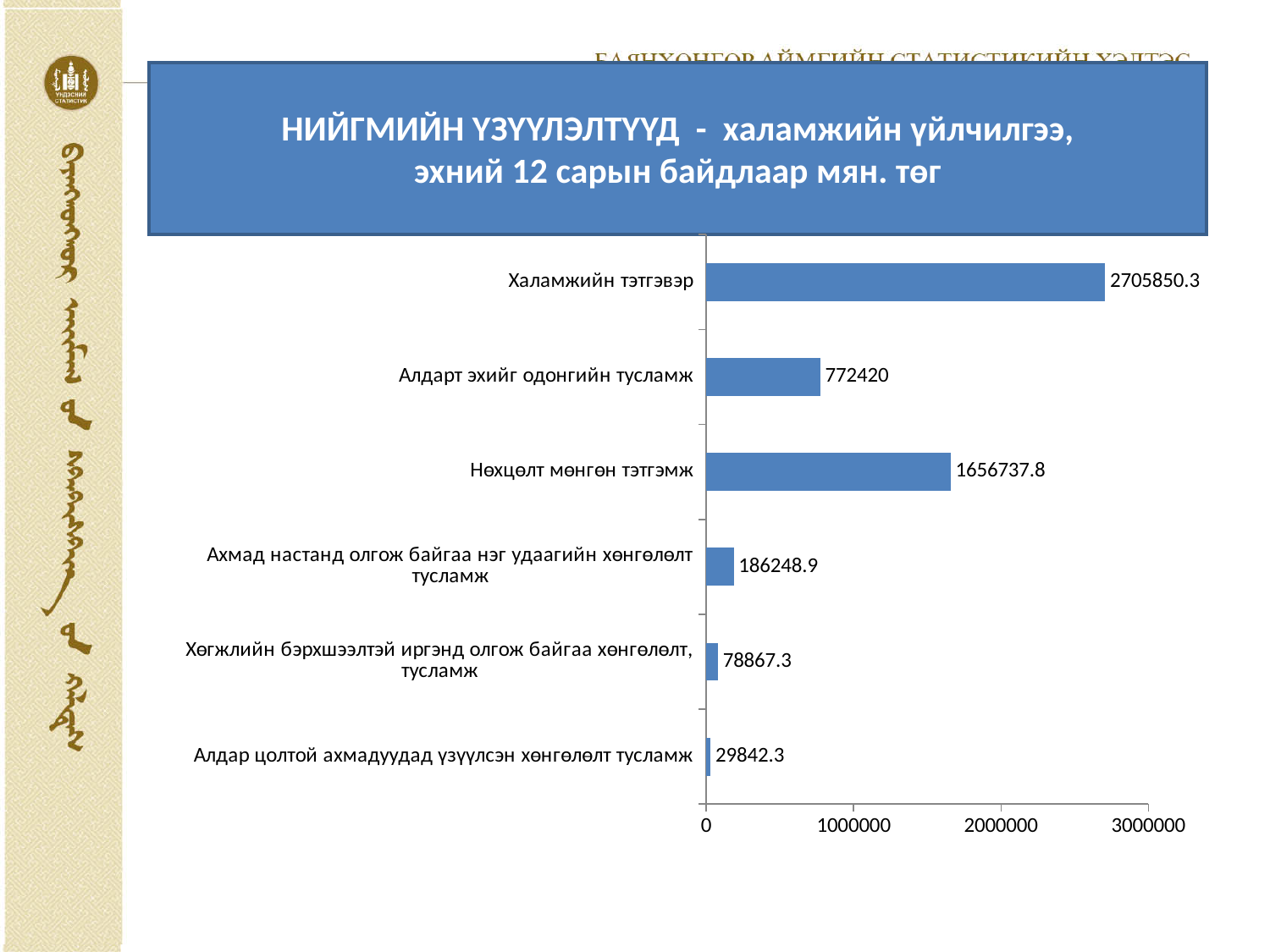
What is the value for Нөхцөлт мөнгөн тэтгэмж? 1656737.8 What is the value for Алдарт эхийг одонгийн тусламж? 772420 What is the difference between the values for Халамжийн тэтгэвэр and Нөхцөлт мөнгөн тэтгэмж? 1049112.5 Which is larger: Алдарт эхийг одонгийн тусламж or Ахмад настанд олгож байгаа нэг удаагийн хөнгөлөлт тусламж? Алдарт эхийг одонгийн тусламж What is the difference between the values for Хөгжлийн бэрхшээлтэй иргэнд олгож байгаа хөнгөлөлт, тусламж and Алдар цолтой ахмадуудад үзүүлсэн хөнгөлөлт тусламж? 49025 What kind of chart is shown on the slide? bar chart Which category has the highest value? Халамжийн тэтгэвэр Is the value for Халамжийн тэтгэвэр greater or less than 2000000? greater What is the value for Халамжийн тэтгэвэр? 2705850.3 Which category has the lowest value? Алдар цолтой ахмадуудад үзүүлсэн хөнгөлөлт тусламж How many categories are shown in the chart? 6 What is the value for Алдар цолтой ахмадуудад үзүүлсэн хөнгөлөлт тусламж? 29842.3